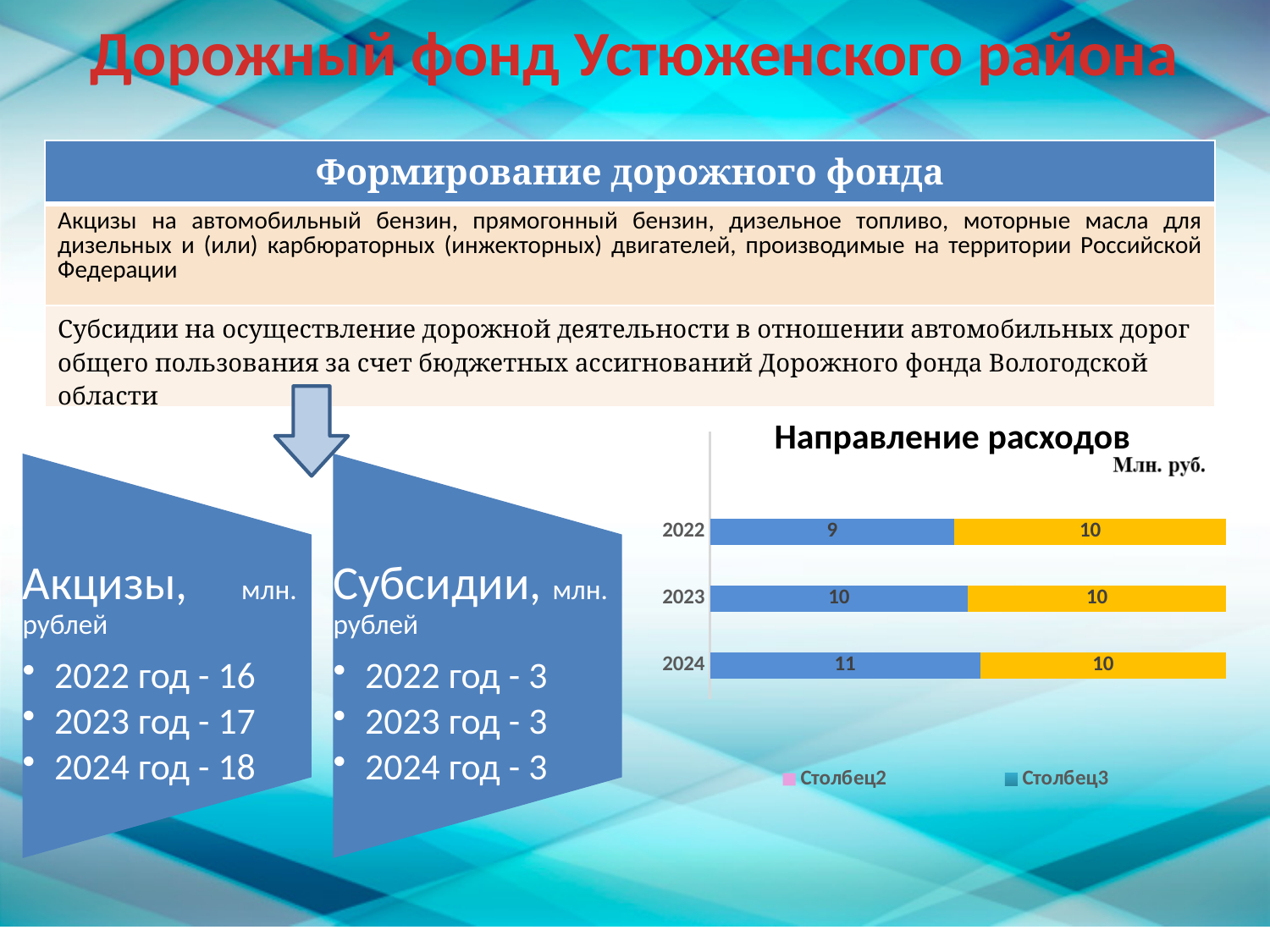
In the "Направление расходов" chart, do the blue segment values rise or fall from 2022 to 2024? rise In the "Направление расходов" chart, what is the value of the blue segment for 2022? 9 In the "Направление расходов" chart, what is the value of the yellow segment for 2023? 10 In the "Направление расходов" chart, what is the total of the stacked bar for 2022? 19 In the "Направление расходов" chart, what is the value of the blue segment for 2024? 11 How many series does the legend of the "Направление расходов" chart list? 2 In the "Направление расходов" chart, which year has the largest blue segment? 2024 In the "Направление расходов" chart, what is the difference between the blue segment for 2024 and the blue segment for 2022? 2 How many years (categories) are plotted in the "Направление расходов" chart? 3 In the "Направление расходов" chart, what is the total of the stacked bar for 2024? 21 In the "Направление расходов" chart, which is larger for 2022: the blue segment or the yellow segment? the yellow segment What kind of chart is shown under the title "Направление расходов"? bar chart